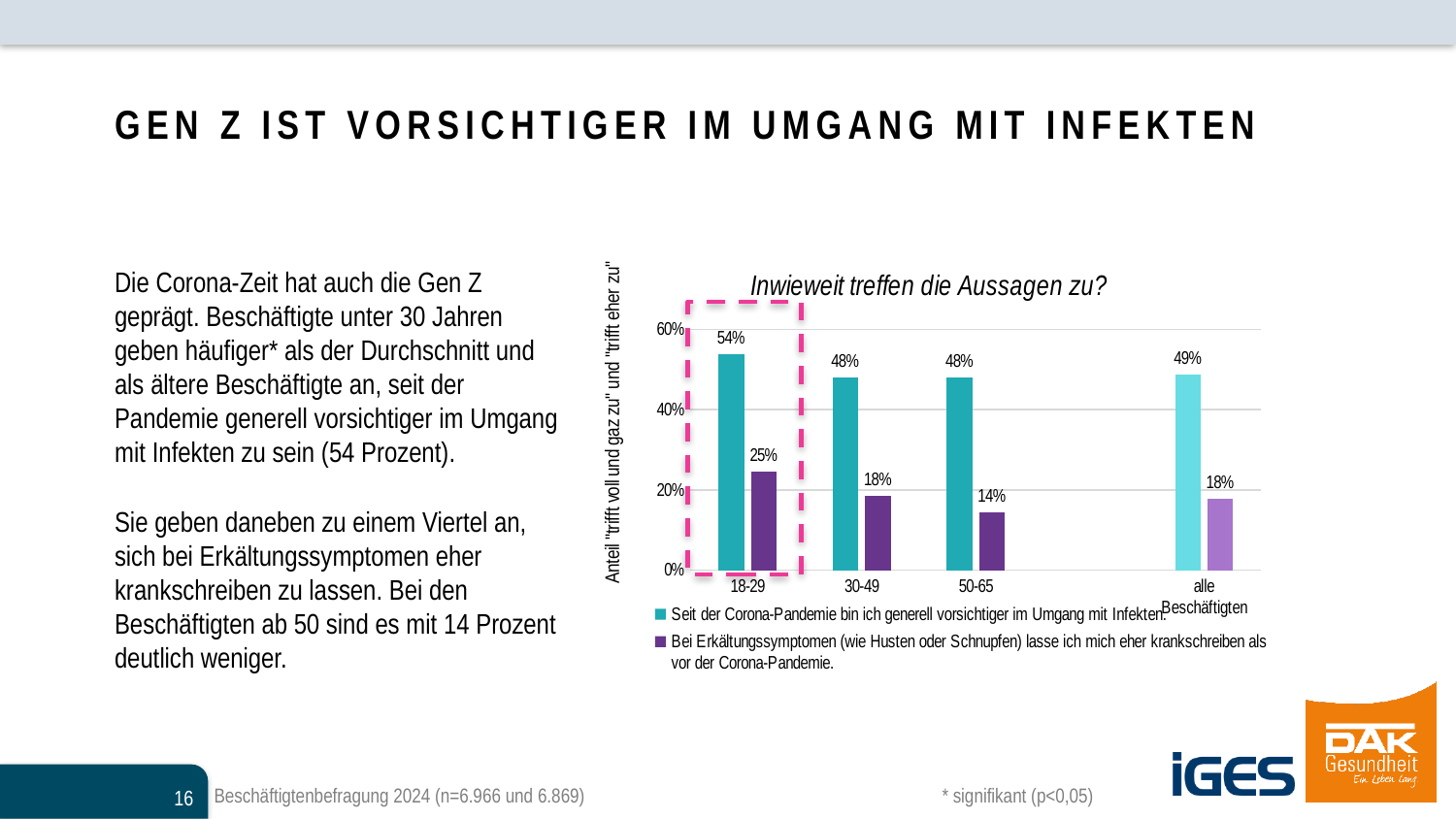
What is the value for the 50-65 group for the series "Bei Erkältungssymptomen ... lasse ich mich eher krankschreiben als vor der Corona-Pandemie"? 14% Which age group has the highest value for the series "Bei Erkältungssymptomen ... lasse ich mich eher krankschreiben"? 18-29 Which category has the lowest value for the series "Bei Erkältungssymptomen ... lasse ich mich eher krankschreiben"? 50-65 What type of chart is shown on the slide? Bar chart Which is larger: the value for 18-29 or the value for 30-49 for the series "Seit der Corona-Pandemie bin ich generell vorsichtiger im Umgang mit Infekten"? 18-29 Is the value for the 30-49 group for the series "Seit der Corona-Pandemie bin ich generell vorsichtiger im Umgang mit Infekten" greater or less than 40%? greater How many categories are shown on the x axis of the chart? 4 What is the value for "alle Beschäftigten" for the series "Seit der Corona-Pandemie bin ich generell vorsichtiger im Umgang mit Infekten"? 49% What is the difference between the two series for the 18-29 group? 29 percentage points What is the value for the 18-29 group for the series "Seit der Corona-Pandemie bin ich generell vorsichtiger im Umgang mit Infekten"? 54% How many series does the chart's legend list? 2 What is the difference between the 18-29 group and the 50-65 group for the series "Bei Erkältungssymptomen ... lasse ich mich eher krankschreiben"? 11 percentage points